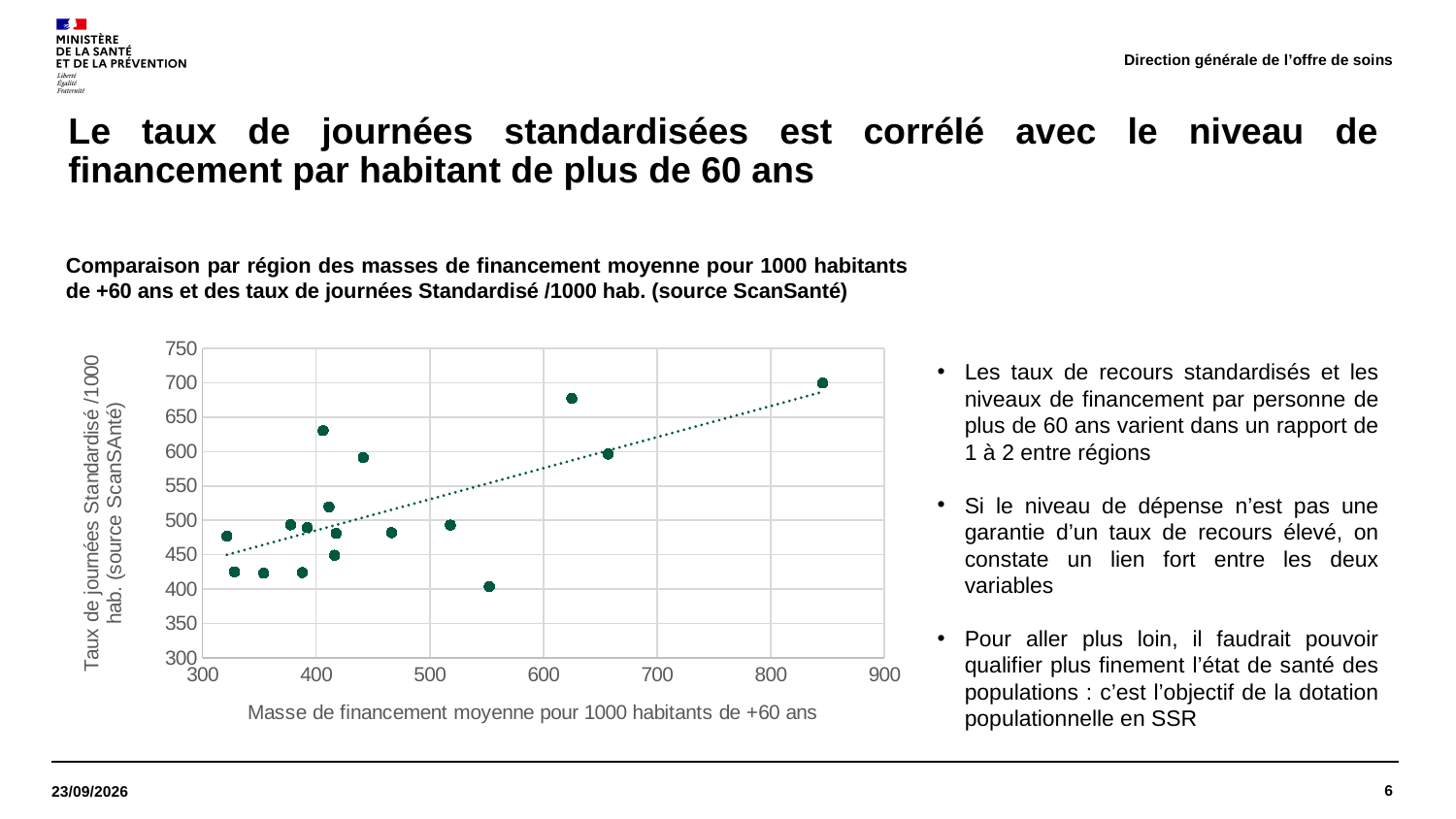
How many points have an x value greater than 700? 1 What is the highest tick value shown on the y axis? 750 What is the highest tick value shown on the x axis? 900 What is the title of the y axis of the chart? Taux de journées Standardisé /1000 hab. (source ScanSAnté) Is the y value of the rightmost point greater or less than 650? greater What kind of chart is shown on the slide? Scatter chart Is the x value of the rightmost point greater or less than 800? greater What is the title of the x axis of the chart? Masse de financement moyenne pour 1000 habitants de +60 ans How many data points are plotted on the chart? 17 Is the y value of the lowest point greater or less than 450? less How many points have a y value greater than 650? 2 Do the plotted values tend to rise or fall as the x-axis value increases? Rise